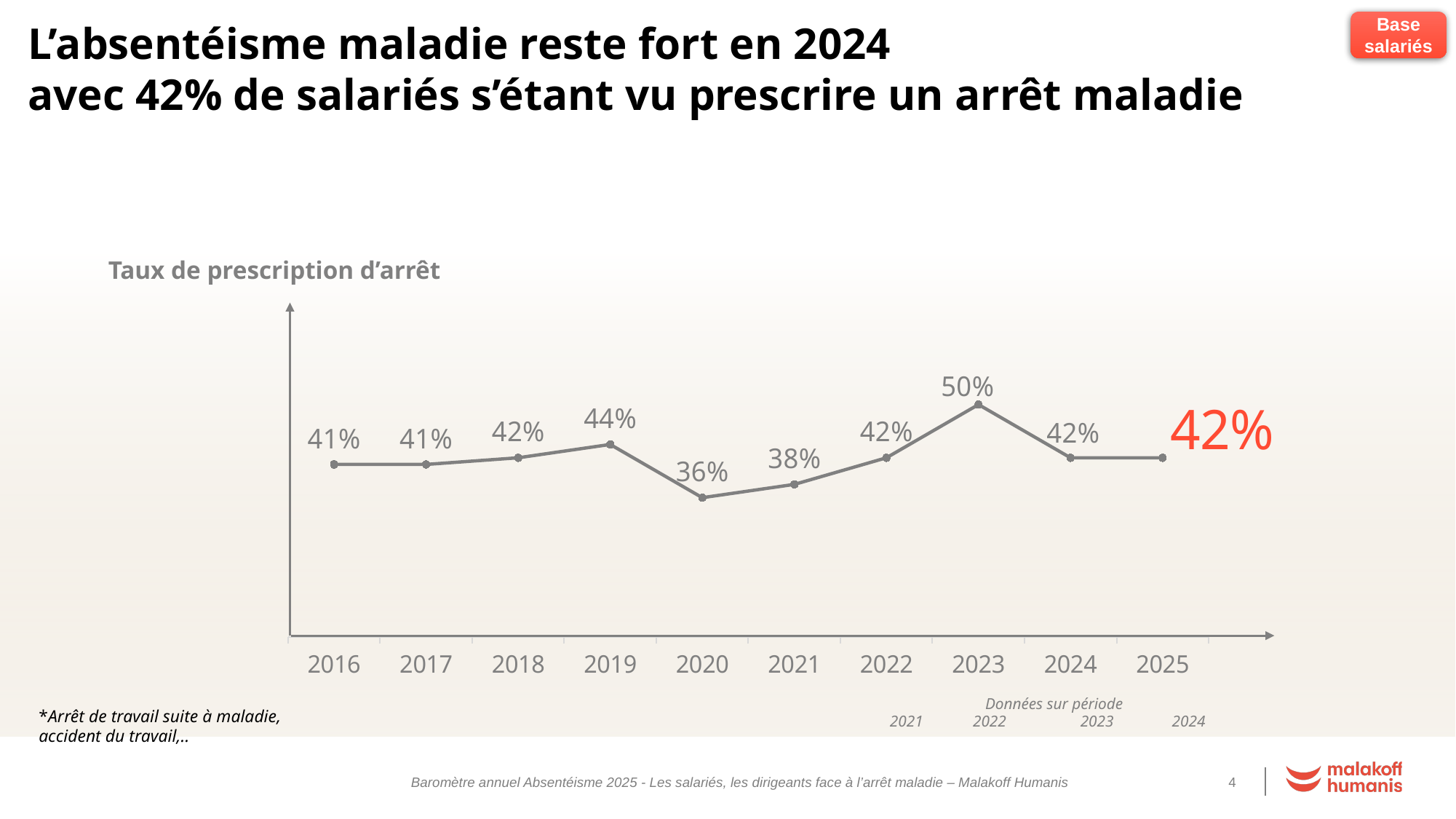
What kind of chart is shown? line chart Which year has the highest value? 2023 What is the difference between the values for 2023 and 2020? 14% What is the value for 2025? 42% What is the difference between the values for 2019 and 2018? 2% What is the title of the chart? Taux de prescription d'arrêt Which year has the lowest value? 2020 What is the value for 2023? 50% What is the value for 2020? 36% How many years are plotted on the chart? 10 What is the value for 2019? 44% Which is larger, the value for 2021 or the value for 2022? 2022